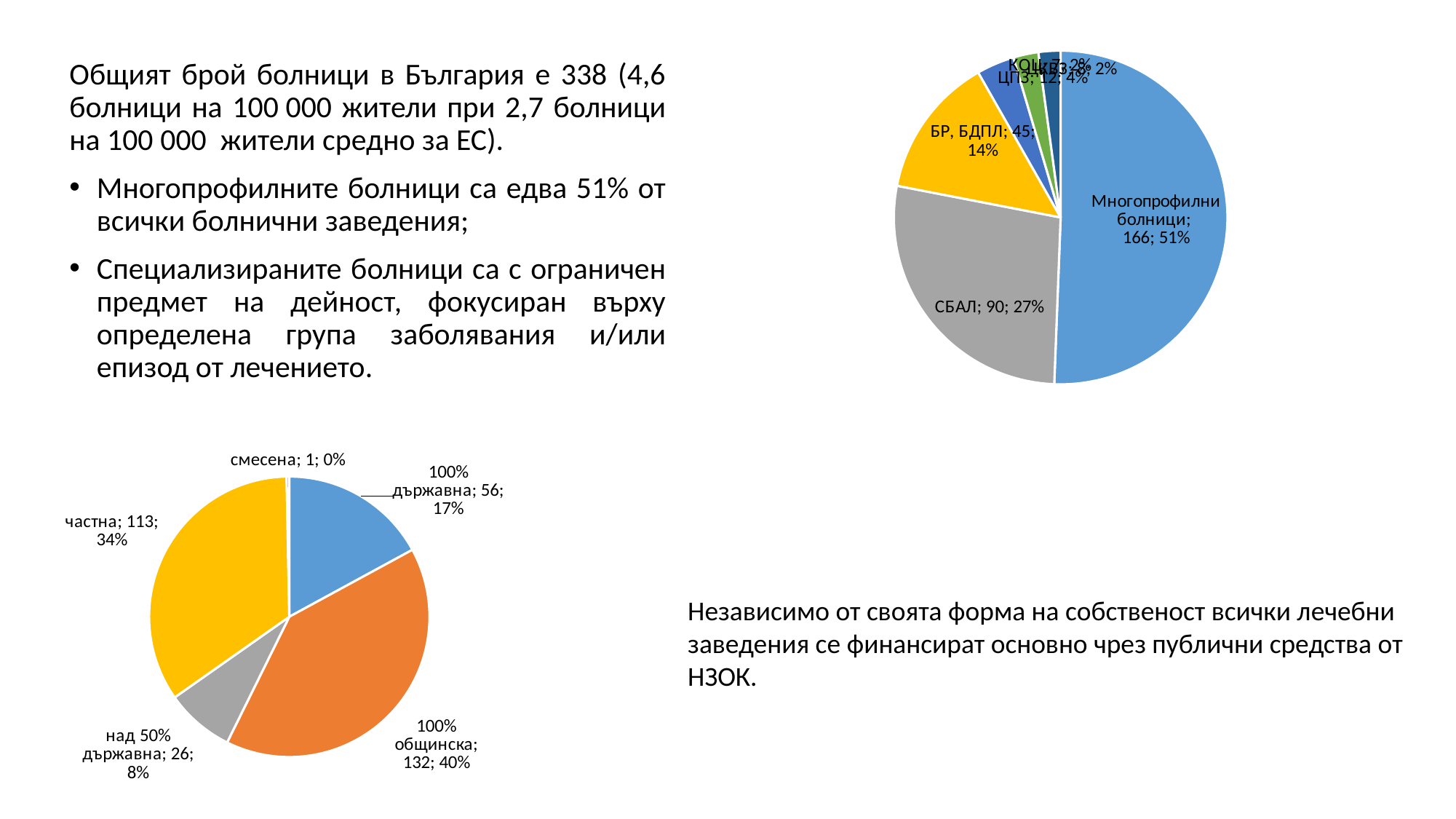
In the bottom-left pie chart, how many categories are shown? 5 In the top-right pie chart, how many hospitals are in the 'Многопрофилни болници' slice? 166 In the top-right pie chart, what share of the pie does 'СБАЛ' represent? 27% In the bottom-left pie chart, what is the value for '100% общинска'? 132 In the bottom-left pie chart, which is larger: '100% държавна' or 'над 50% държавна'? 100% държавна In the top-right pie chart, what is the value for 'БР, БДПЛ'? 45 In the top-right pie chart, which category has the largest slice? Многопрофилни болници In the bottom-left pie chart, what share of the pie does 'частна' represent? 34% In the top-right pie chart, what is the difference between the values for 'Многопрофилни болници' and 'СБАЛ'? 76 In the bottom-left pie chart, what is the difference between the values for 'частна' and '100% държавна'? 57 In the bottom-left pie chart, which category has the smallest slice? смесена What kind of chart is the bottom-left chart? Pie chart